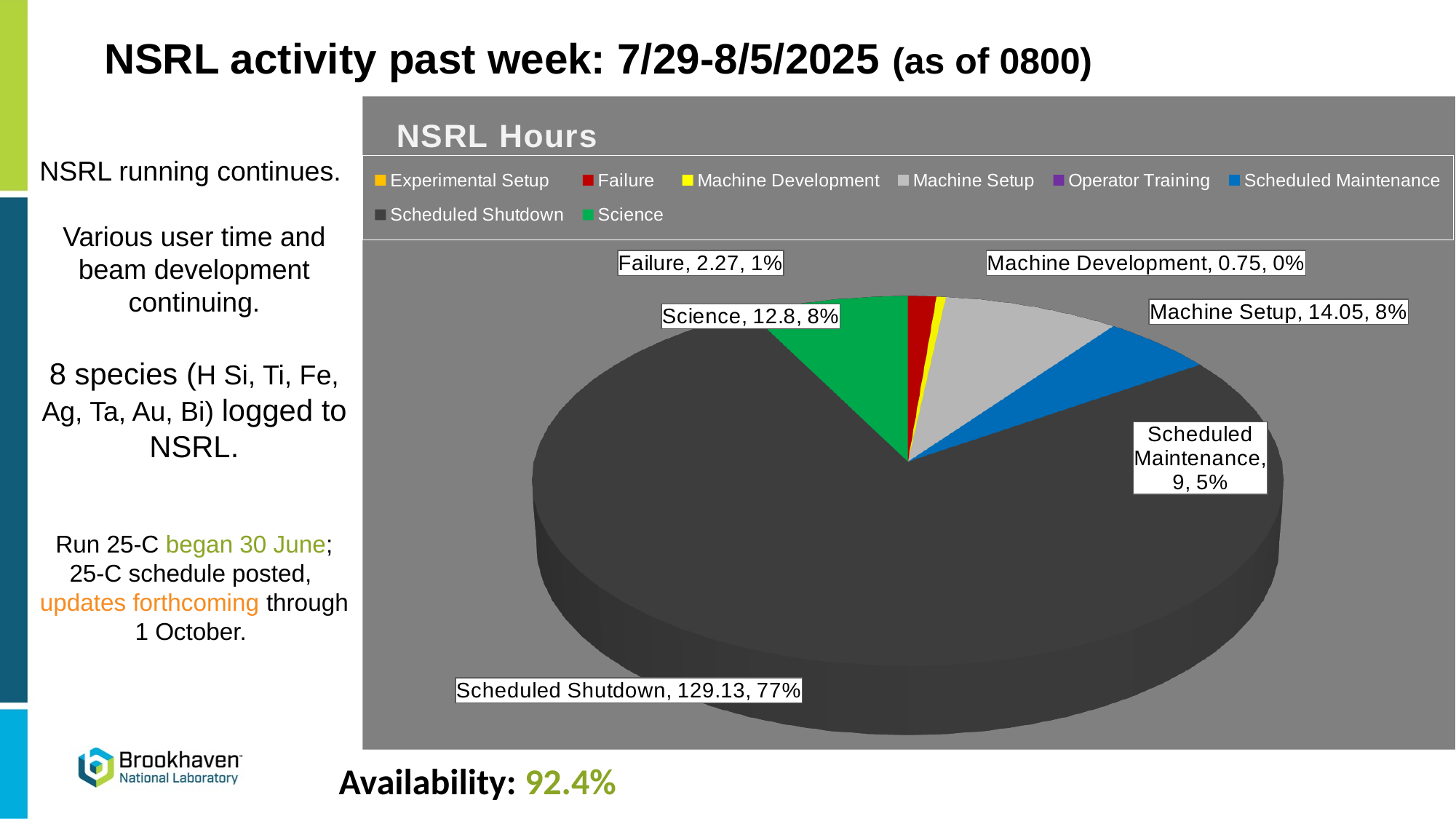
Which labelled category has the smallest slice of the pie? Machine Development How many series does the chart legend list? 8 What is the difference in hours between Science and Scheduled Maintenance? 3.8 How many hours are shown for Failure? 2.27 How many hours are shown for Machine Setup? 14.05 Which has more hours, Machine Setup or Science? Machine Setup What share of the pie does Scheduled Shutdown represent? 77% How many hours are shown for Scheduled Shutdown? 129.13 What share of the pie does Scheduled Maintenance represent? 5% Which labelled category has the largest slice of the pie? Scheduled Shutdown What type of chart is shown on the slide? pie chart What is the title of the chart? NSRL Hours